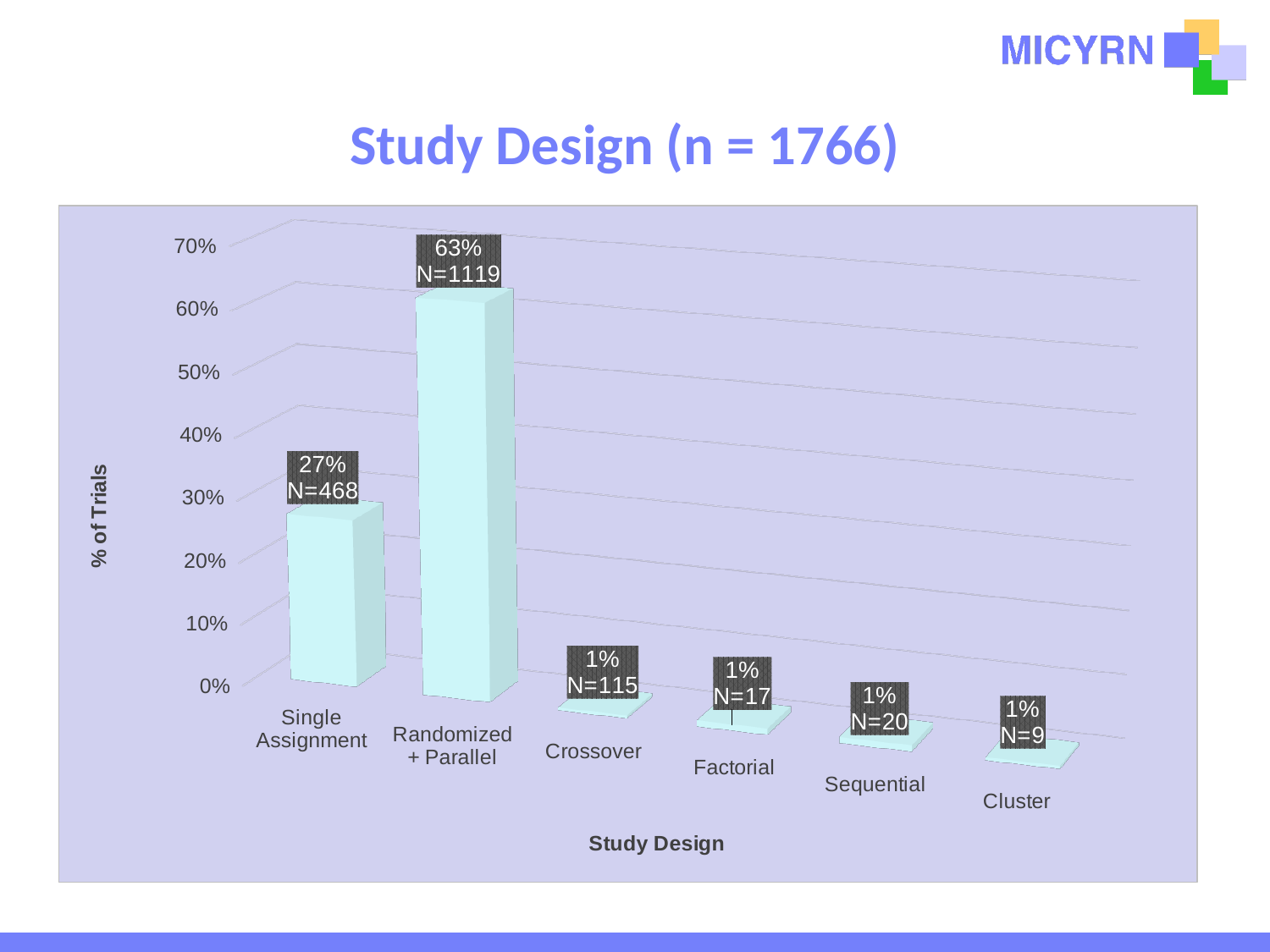
What is the label of the vertical axis of the chart? % of Trials What percentage of trials used a Single Assignment study design? 27% What percentage of trials used a Randomized + Parallel study design? 63% Which study design has the highest percentage of trials? Randomized + Parallel What is the N value shown for the Crossover study design? N=115 How many study design categories are shown on the chart? 6 What type of chart is shown on the slide? Bar chart What is the difference in percentage points between the Randomized + Parallel and Single Assignment study designs? 36% What is the N value shown for the Single Assignment study design? N=468 Is the value for Single Assignment greater or less than 30%? less Which has more trials, Sequential or Factorial? Sequential Which study design has the smallest N value shown on the chart? Cluster